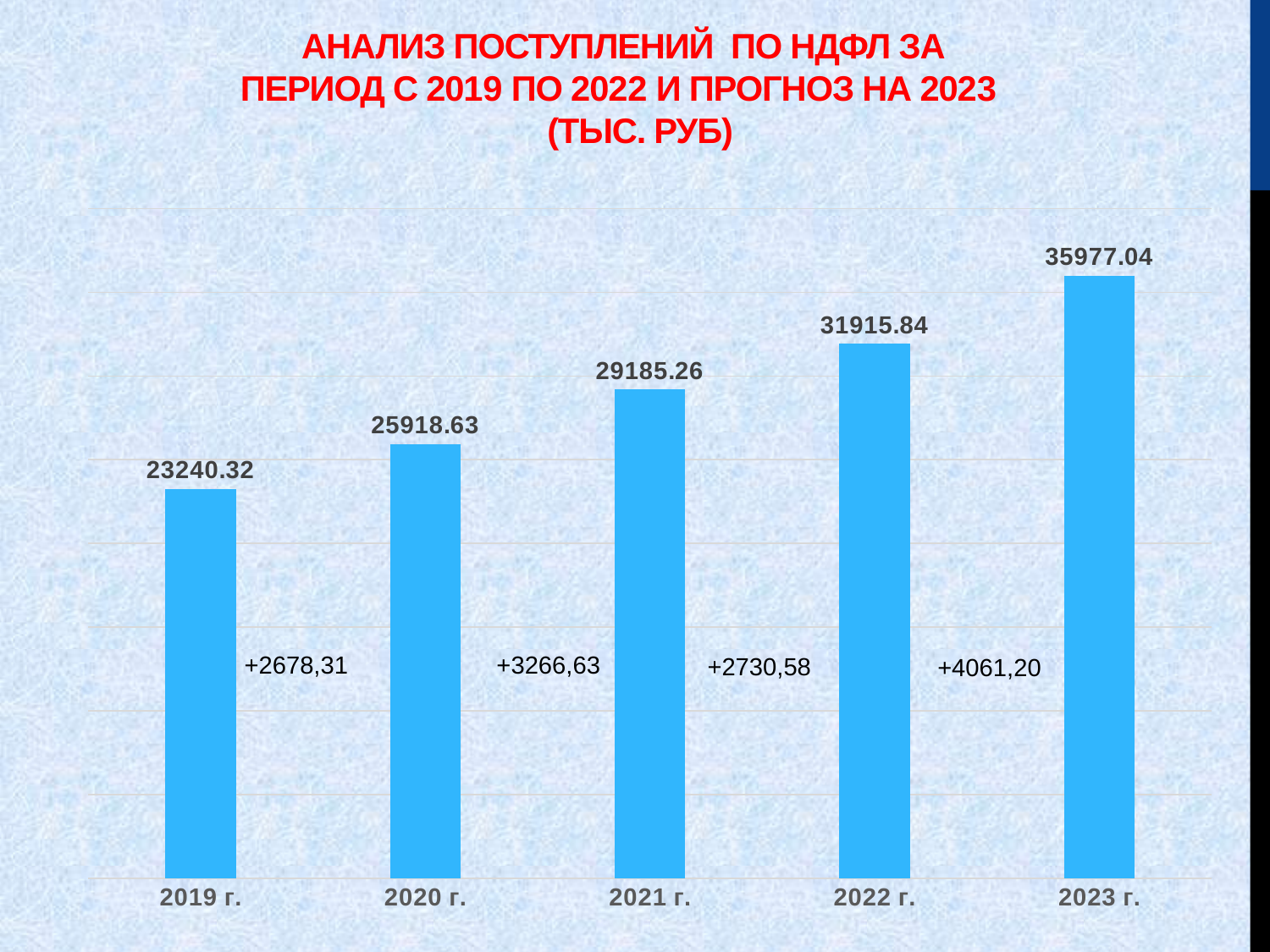
What is the value for 2021 г.? 29185.26 What kind of chart is shown on the slide? Bar chart What is the value for 2022 г.? 31915.84 What is the forecast value shown for 2023 г.? 35977.04 Which year has the lowest value? 2019 г. Do the values rise or fall from 2019 г. to 2023 г.? Rise What is the difference between the values for 2020 г. and 2019 г.? 2678.31 What is the difference between the values for 2023 г. and 2022 г.? 4061.20 How many years (bars) are shown in the chart? 5 Which year has the highest value? 2023 г. What is the value for 2019 г.? 23240.32 Which is larger, the value for 2021 г. or the value for 2020 г.? 2021 г.